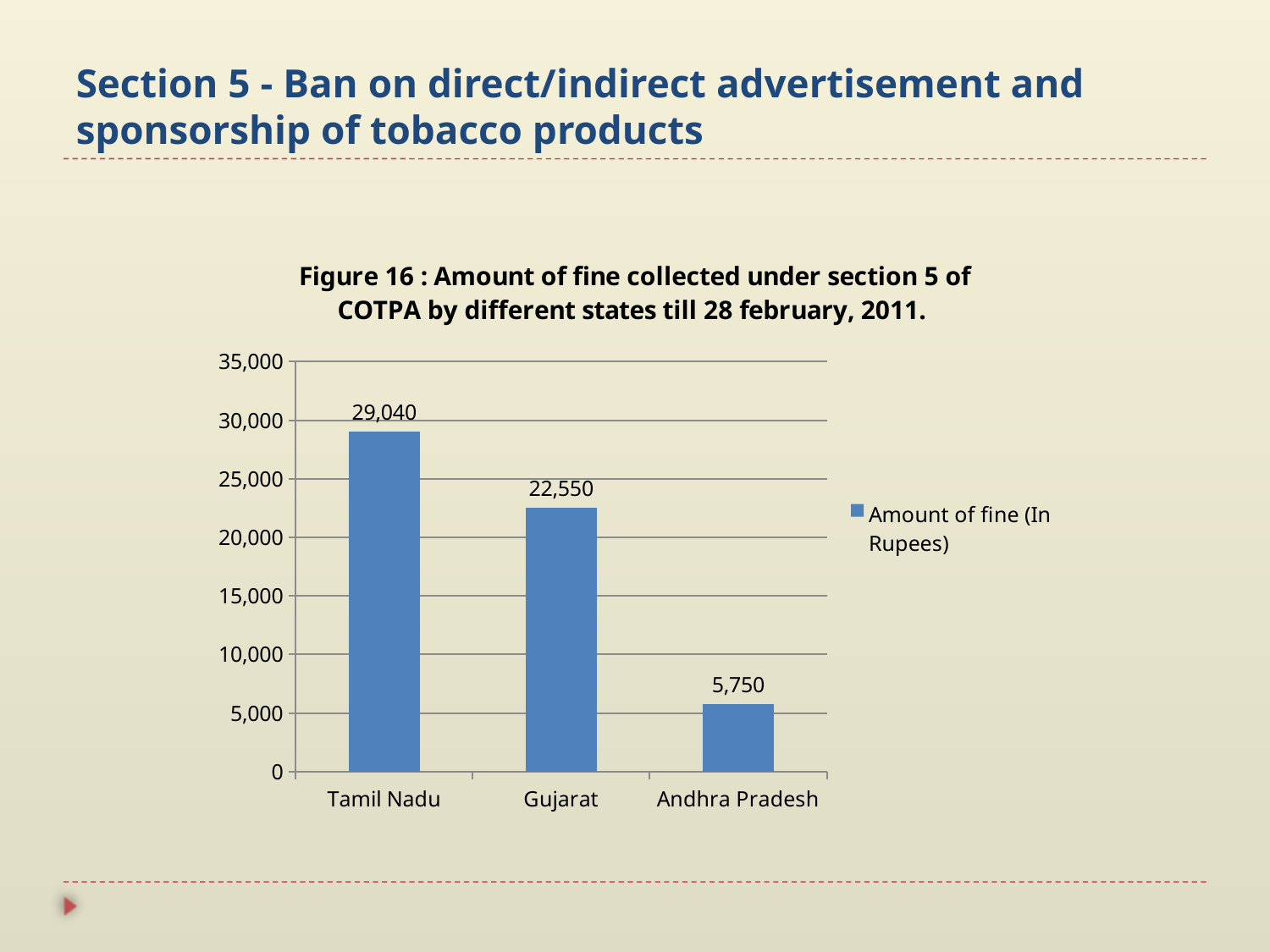
How many states are shown in the chart? 3 Which state has the lowest amount of fine collected? Andhra Pradesh What is the amount of fine collected for Andhra Pradesh? 5,750 What is the difference between the fine collected in Gujarat and Andhra Pradesh? 16,800 Which state collected a larger fine, Gujarat or Andhra Pradesh? Gujarat What is the amount of fine collected for Tamil Nadu? 29,040 What is the difference between the fine collected in Tamil Nadu and Gujarat? 6,490 What kind of chart is shown on the slide? Bar chart What is the legend entry for the series in the chart? Amount of fine (In Rupees) Which state has the highest amount of fine collected? Tamil Nadu What is the amount of fine collected for Gujarat? 22,550 Is the value for Gujarat greater or less than 20,000? greater